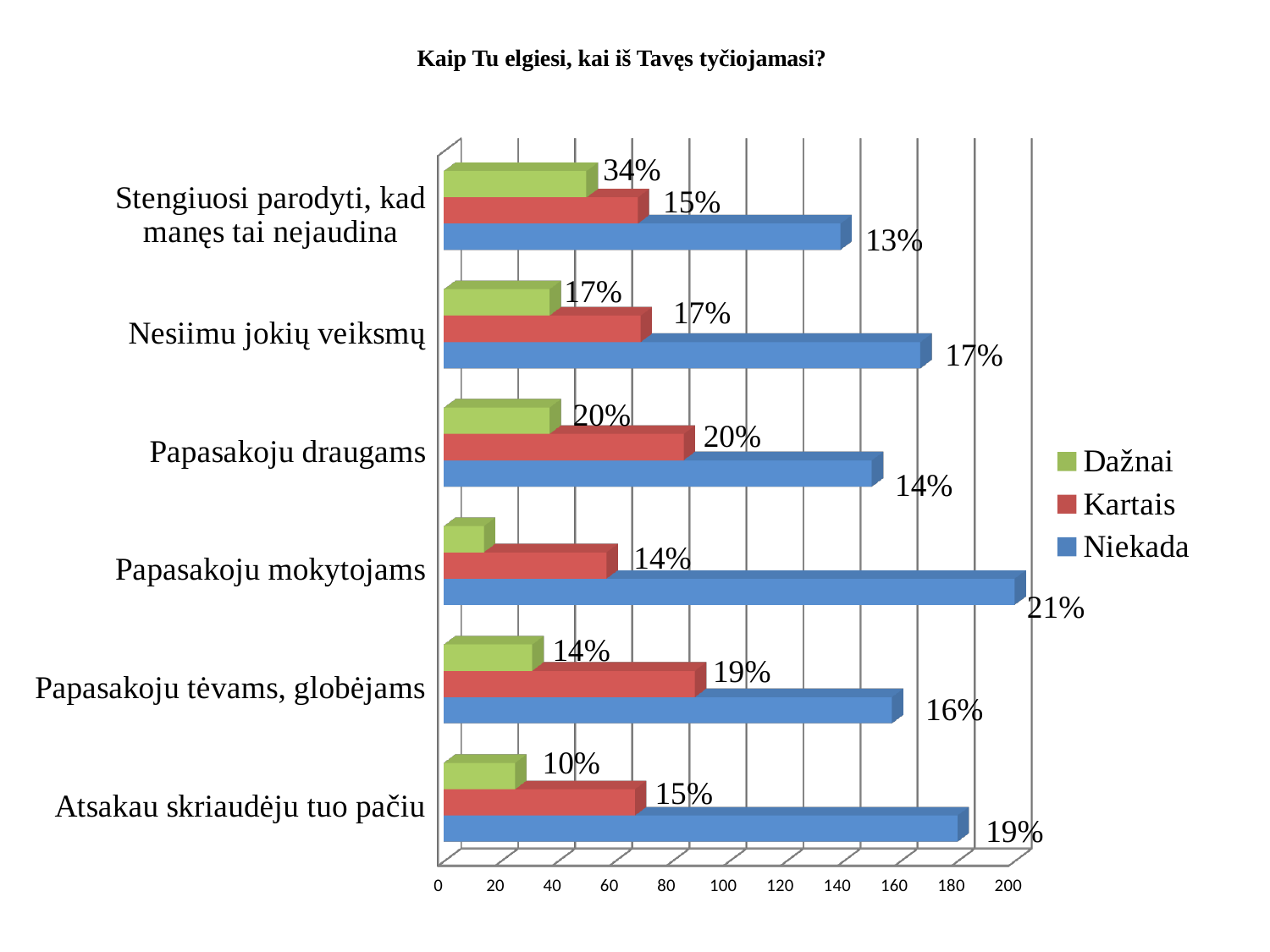
What is the Niekada value for "Papasakoju mokytojams"? 21% What is the Kartais value for "Papasakoju tėvams, globėjams"? 19% Which is larger: the Kartais value for "Papasakoju draugams" or the Kartais value for "Atsakau skriaudėju tuo pačiu"? Papasakoju draugams What kind of chart is shown on the slide? bar chart How many categories are shown on the chart? 6 Which category has the highest Dažnai value? Stengiuosi parodyti, kad manęs tai nejaudina Is the Niekada bar for "Papasakoju mokytojams" greater or less than 180 on the axis? greater What is the title of the chart? Kaip Tu elgiesi, kai iš Tavęs tyčiojamasi? Which category has the lowest Dažnai bar? Papasakoju mokytojams How many series does the legend list? 3 What is the Dažnai value for "Stengiuosi parodyti, kad manęs tai nejaudina"? 34% What is the difference between the Dažnai and Kartais values for "Stengiuosi parodyti, kad manęs tai nejaudina"? 19%